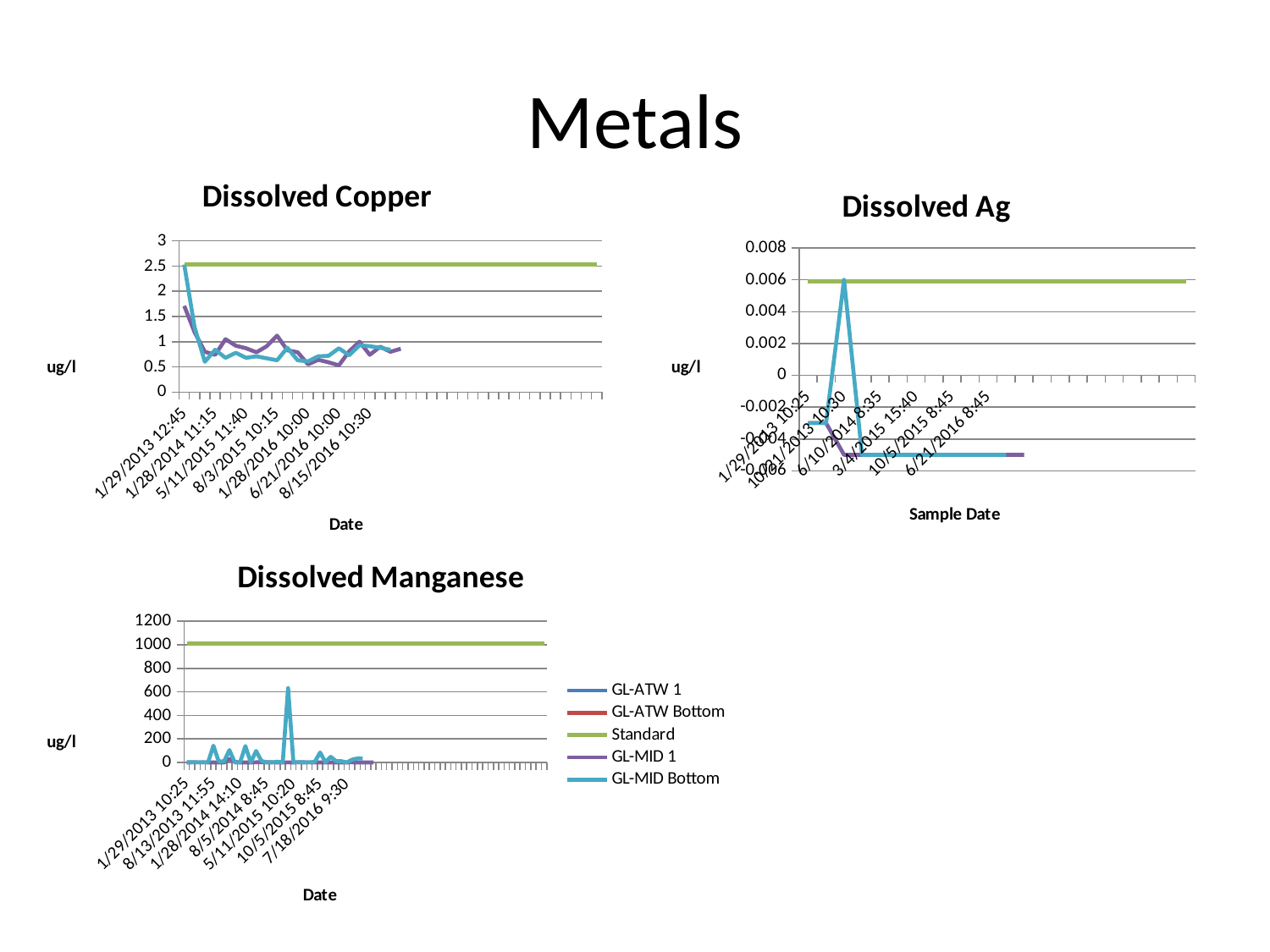
What is the x-axis title of the Dissolved Ag chart? Sample Date In the Dissolved Manganese chart, is the Standard line greater or less than 800? greater In the Dissolved Manganese chart, is the highest peak of the GL-MID Bottom line greater or less than 400? greater In the Dissolved Ag chart, is the peak of the GL-MID Bottom line greater or less than 0.004? greater In the Dissolved Copper chart, does the GL-MID Bottom line rise or fall between its first and second points? fall In the Dissolved Copper chart, which is higher across the dates, the Standard line or the GL-MID Bottom line? Standard What is the y-axis label of the Dissolved Copper chart? ug/l What kind of chart is the Dissolved Copper chart? line chart How many charts are shown on the slide? 3 How many series does the legend on the slide list? 5